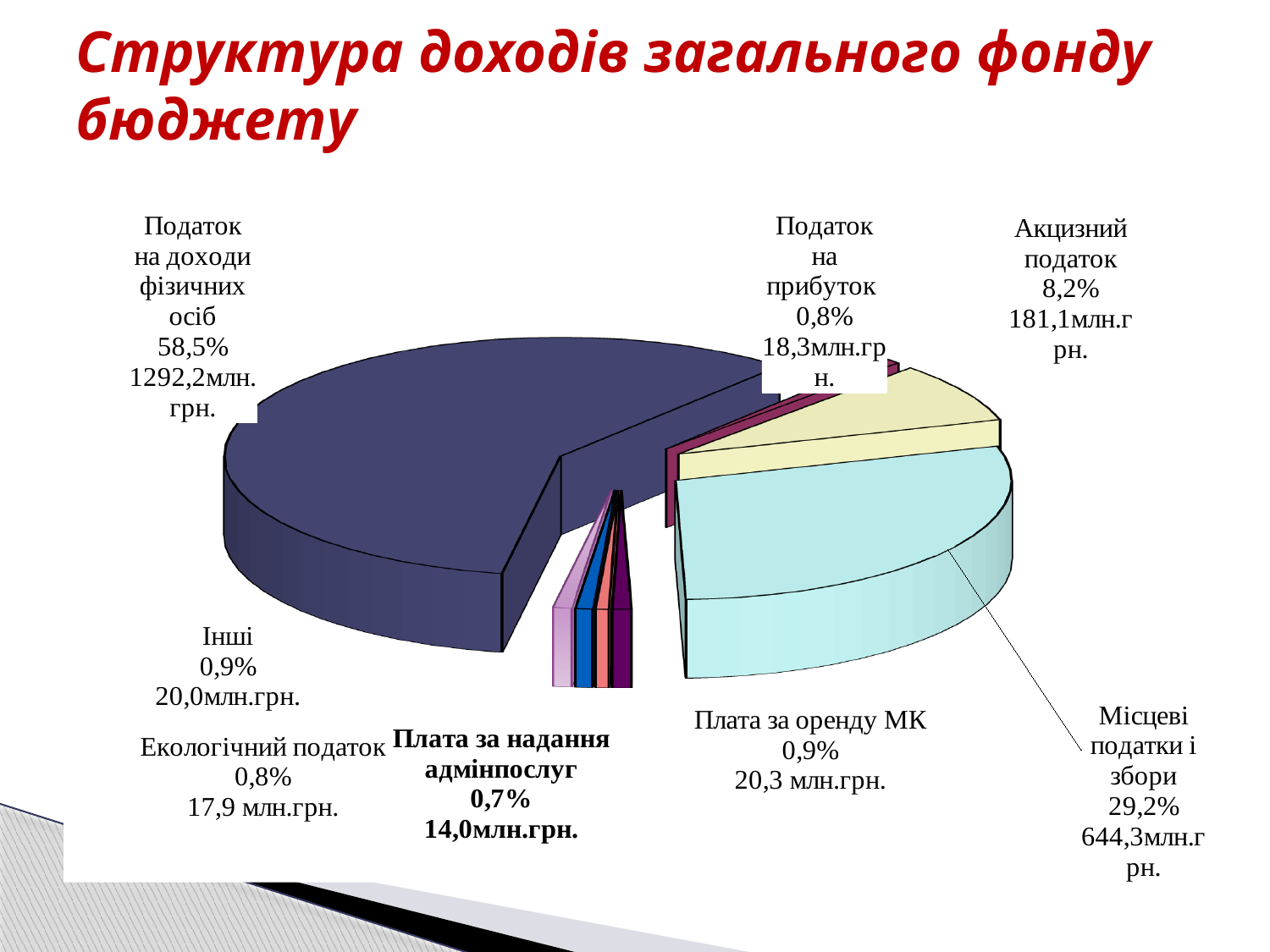
What is the amount shown for "Місцеві податки і збори"? 644,3млн.грн. What is the title of the chart on the slide? Структура доходів загального фонду бюджету Which is larger: the share for "Акцизний податок" or the share for "Податок на прибуток"? Акцизний податок What is the amount shown for "Плата за надання адмінпослуг"? 14,0млн.грн. Which category has the smallest share of the pie? Плата за надання адмінпослуг What kind of chart is shown on the slide? Pie chart What share of the pie does "Податок на доходи фізичних осіб" represent? 58,5% What is the difference in percentage points between "Податок на доходи фізичних осіб" and "Місцеві податки і збори"? 29,3 What is the amount shown for "Екологічний податок"? 17,9 млн.грн. Which category has the largest share of the pie? Податок на доходи фізичних осіб How many categories are shown in the pie chart? 8 What share of the pie does "Акцизний податок" represent? 8,2%